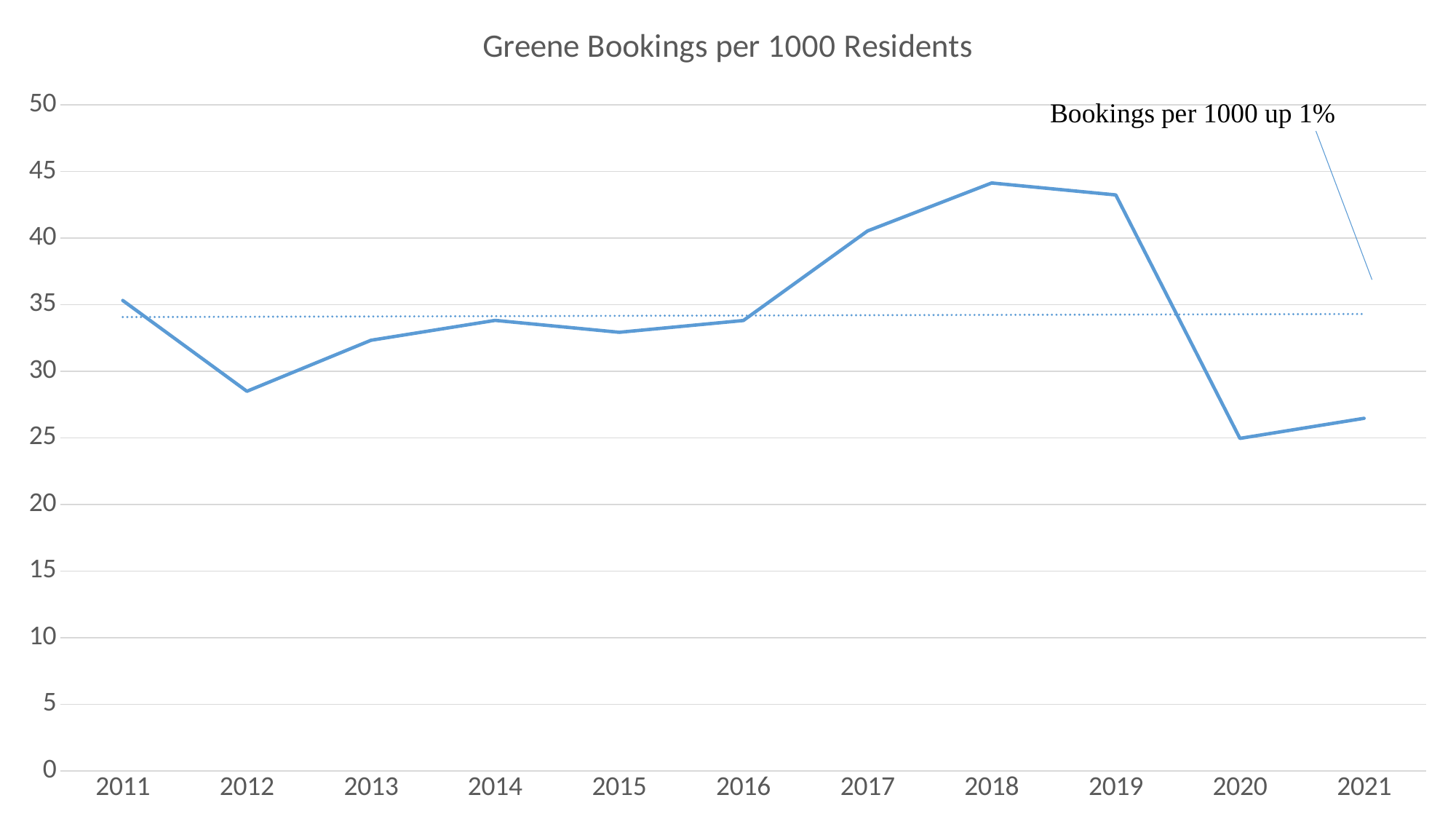
Is the value for 2012 greater or less than 30? less Is the value for 2020 greater or less than 30? less What is the title of the chart? Greene Bookings per 1000 Residents What does the annotation text on the chart say? Bookings per 1000 up 1% Is the value for 2013 greater or less than 30? greater Which year has the larger value, 2011 or 2012? 2011 In which year is the value highest? 2018 What type of chart is shown on the slide? line chart Do the values rise or fall from 2016 to 2018? rise In which year is the value lowest? 2020 How many years are plotted along the x axis? 11